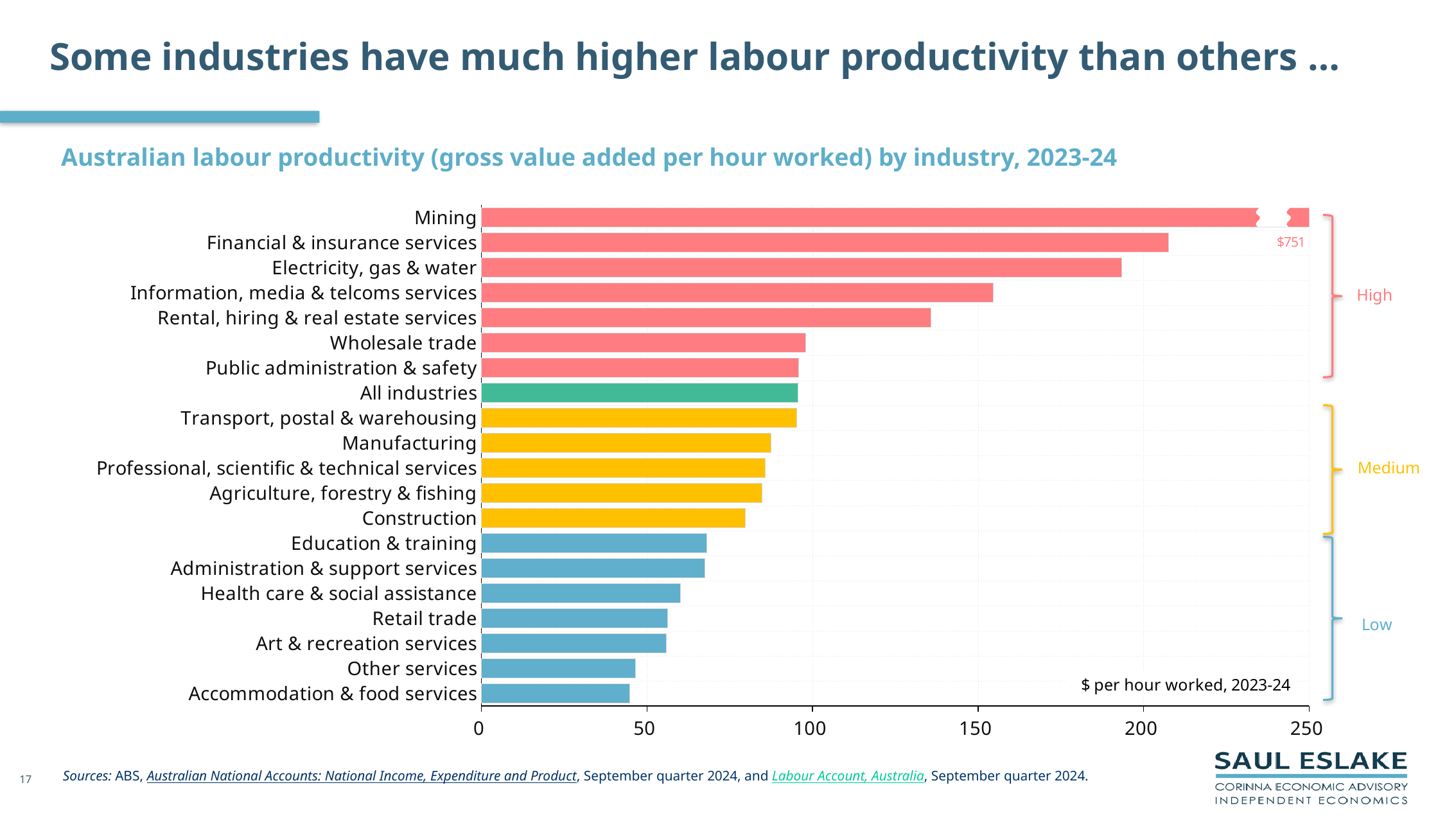
Is the value for Financial & insurance services greater or less than 200? greater Which is larger, the value for Electricity, gas & water or the value for Information, media & telcoms services? Electricity, gas & water Is the value for Education & training greater or less than 50? greater How many bars (categories) are plotted in the chart? 20 Is the value for Electricity, gas & water greater or less than 200? less What kind of chart is shown on the slide? bar chart What is the labour productivity value shown for Mining? $751 Which industry has the highest labour productivity in the chart? Mining What is the title of the chart? Australian labour productivity (gross value added per hour worked) by industry, 2023-24 What are the three group labels shown to the right of the bars? High, Medium, Low